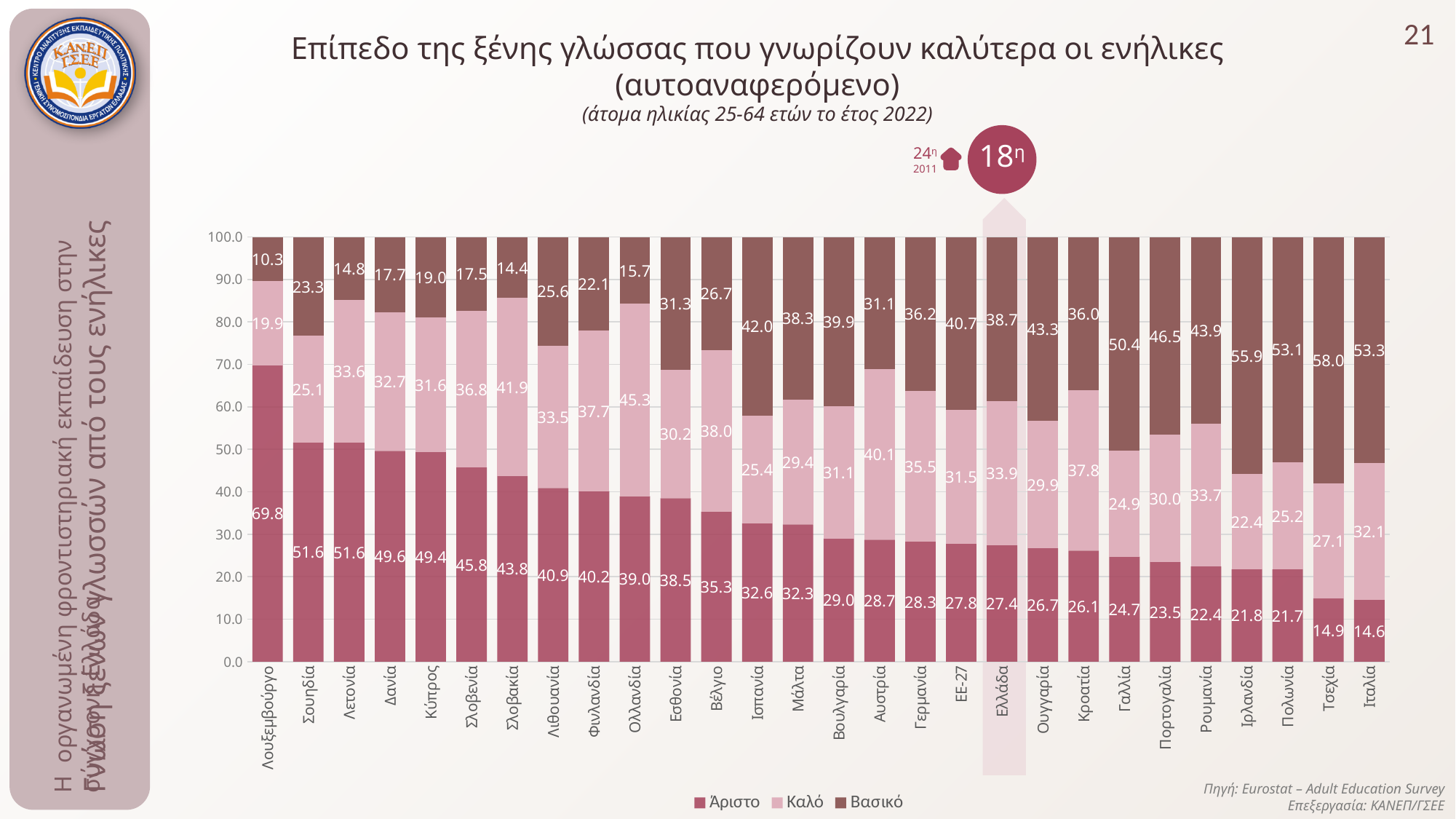
What is the total of the stacked bar for Ελλάδα? 100.0 How many series does the legend list? 3 Which country has the highest Βασικό value? Τσεχία What is the difference between the Βασικό value for ΕΕ-27 and the Βασικό value for Ελλάδα? 2.0 How many countries/categories are shown on the x axis? 28 Which country has the lowest Βασικό value? Λουξεμβούργο What is the Άριστο value for Ελλάδα? 27.4 What kind of chart is shown on the slide? stacked bar chart What is the Βασικό value for ΕΕ-27? 40.7 For Ολλανδία, which is larger: the Καλό value or the Άριστο value? Καλό Which country has the highest Άριστο value? Λουξεμβούργο What is the Καλό value for Ολλανδία? 45.3